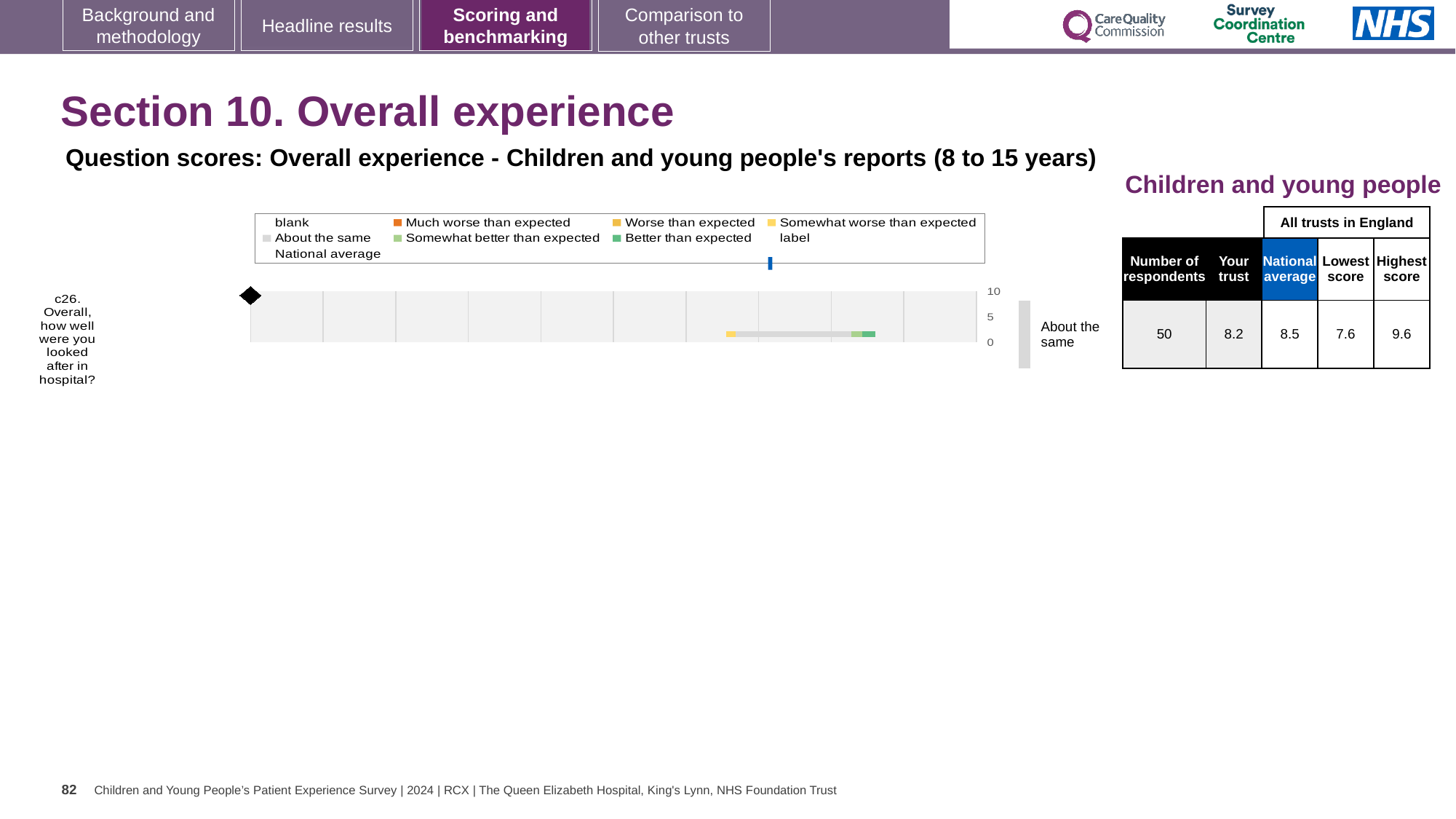
How many survey questions are plotted on the chart? 1 What kind of chart is used to show the question score? Bar chart What is the difference between the highest score (9.6) and the lowest score (7.6) for question c26? 2.0 What is the national average score for question c26? 8.5 What is the lowest score among all trusts in England for question c26? 7.6 What is the 'Your trust' score for question c26 'Overall, how well were you looked after in hospital?'? 8.2 What is the highest score among all trusts in England for question c26? 9.6 How many respondents answered question c26? 50 Is the trust's score for question c26 greater or less than 5 on the chart's axis? greater Which is larger for question c26: the trust's score or the national average? National average What benchmark category is the trust's result for question c26 labelled as on the chart? About the same What is the difference between the national average (8.5) and the trust's score (8.2) for question c26? 0.3